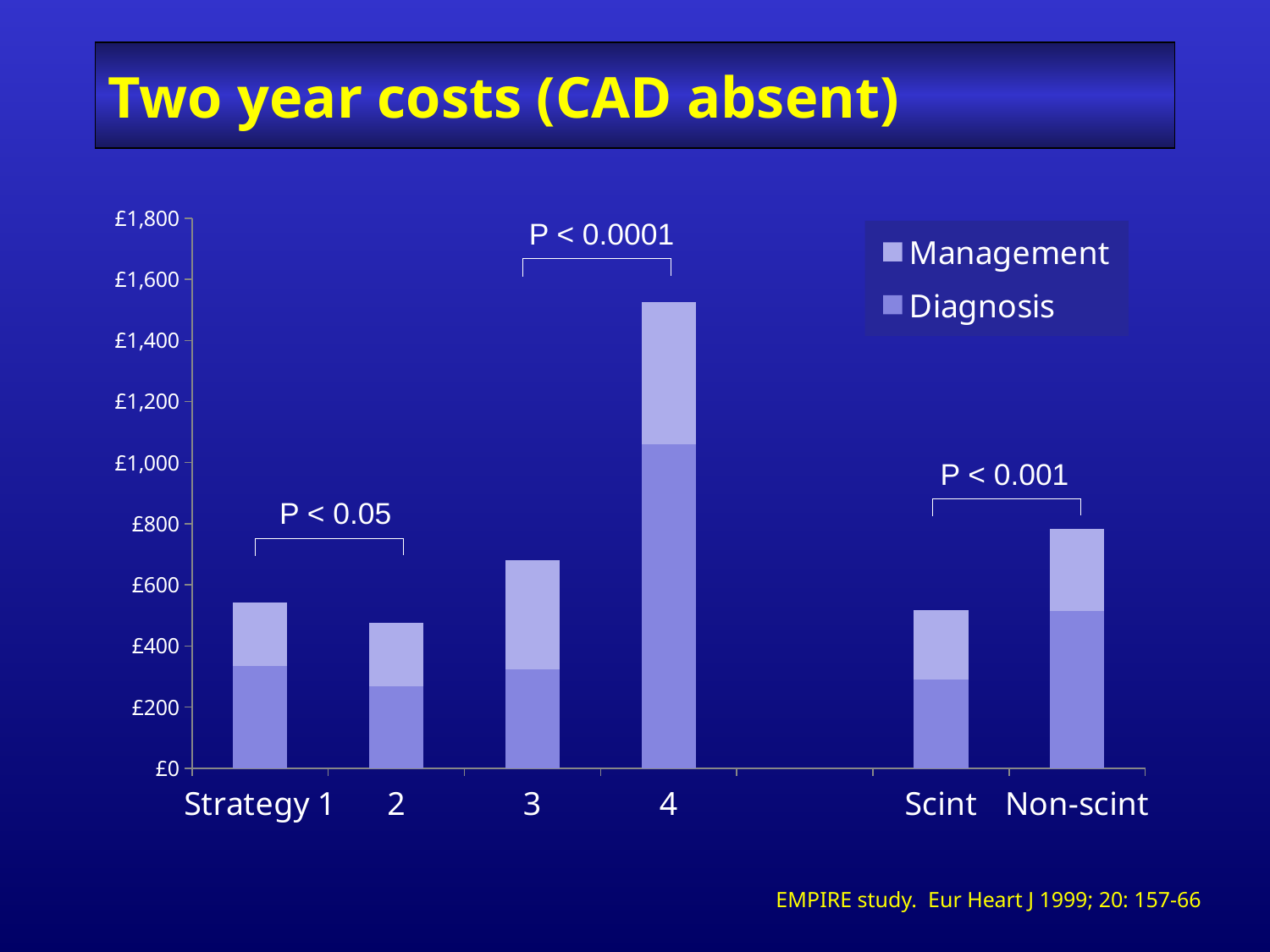
Which has the larger total cost, Strategy 3 or Strategy 4? Strategy 4 How many series does the legend list? 2 Which category has the highest total two year cost? Strategy 4 What kind of chart is shown on the slide? Stacked bar chart Is the total cost for Strategy 3 greater or less than £600? greater What are the two series named in the legend? Management and Diagnosis What is the title of the chart on the slide? Two year costs (CAD absent) Is the total cost for Strategy 4 greater or less than £1,400? greater How many bars are plotted in the chart? 6 Is the total cost for Scint greater or less than £600? less Which has the larger total cost, Scint or Non-scint? Non-scint